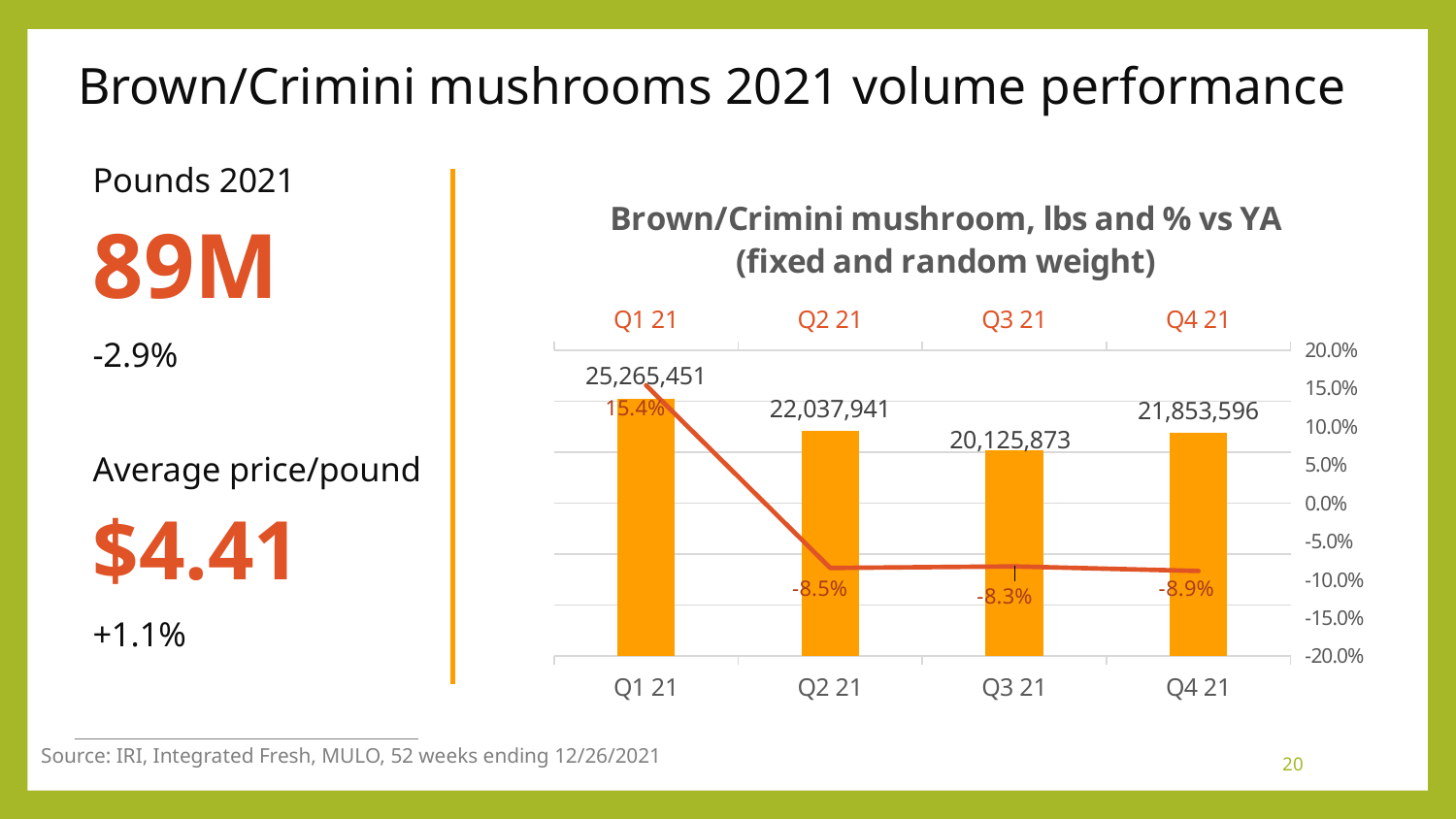
What is the pounds value for Q3 21? 20,125,873 Which quarter has the lowest pounds value? Q3 21 How many quarters are shown on the x axis? 4 What is the pounds value for Q1 21? 25,265,451 Which quarter has a larger pounds value, Q2 21 or Q4 21? Q2 21 Is the % vs YA value for Q1 21 greater or less than 10.0%? greater What is the % vs YA value for Q4 21? -8.9% What is the % vs YA value for Q2 21? -8.5% What is the title of the chart? Brown/Crimini mushroom, lbs and % vs YA (fixed and random weight) Which quarter has the highest pounds value? Q1 21 What kind of chart is this? Combination bar and line chart What is the difference in pounds between Q1 21 and Q2 21? 3,227,510